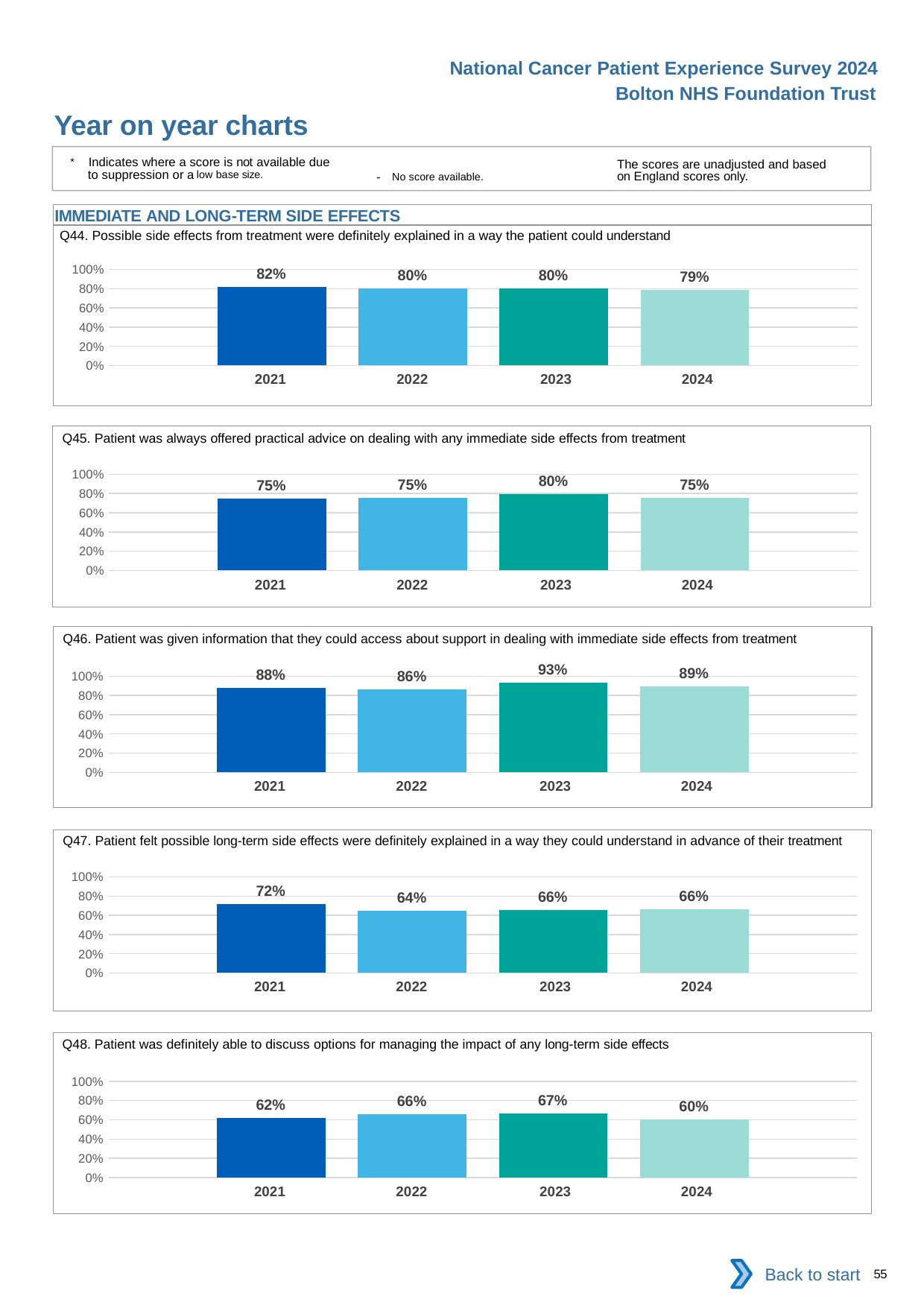
In the Q48 chart, which year has the lowest value? 2024 In the Q45 chart, what is the difference between the 2023 value and the 2024 value? 5 percentage points In the Q45 chart, which year has the highest value? 2023 In the Q47 chart, which year has the highest value? 2021 In the Q44 chart, which year has the lowest value? 2024 In the Q46 chart, which is larger, the value for 2021 or the value for 2022? 2021 What kind of chart is the Q46 chart? Bar chart In the Q46 chart, what is the value for 2023? 93% How many years are shown on the x axis of the Q44 chart? 4 In the Q47 chart, what is the difference between the 2021 value and the 2022 value? 8 percentage points In the Q48 chart, what is the value for 2024? 60% In the Q44 chart, what is the value for 2021? 82%